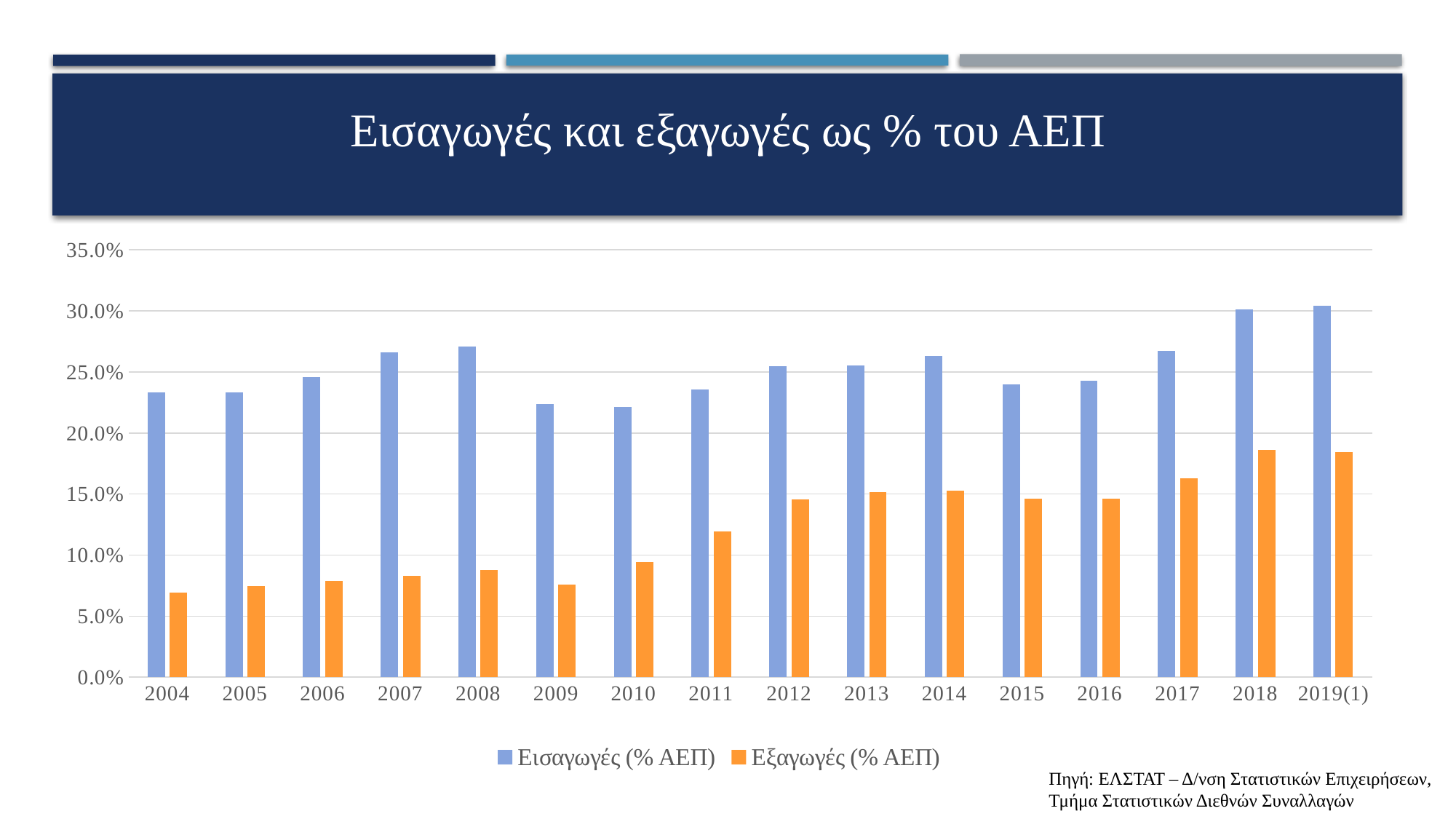
Is the value for Εισαγωγές (% ΑΕΠ) in 2010 greater or less than 25.0%? less Do the values for Εξαγωγές (% ΑΕΠ) generally rise or fall from 2004 to 2019(1)? Rise How many series does the legend list? 2 What is the title of the chart? Εισαγωγές και εξαγωγές ως % του ΑΕΠ Is the value for Εξαγωγές (% ΑΕΠ) in 2017 greater or less than 15.0%? greater Which is larger: Εισαγωγές (% ΑΕΠ) in 2008 or in 2009? 2008 Is the value for Εξαγωγές (% ΑΕΠ) in 2011 greater or less than 10.0%? greater Which is larger: Εξαγωγές (% ΑΕΠ) in 2010 or in 2012? 2012 How many years (categories) are shown on the x axis? 16 Which year has the lowest value for Εξαγωγές (% ΑΕΠ)? 2004 What kind of chart is shown on the slide? Bar chart